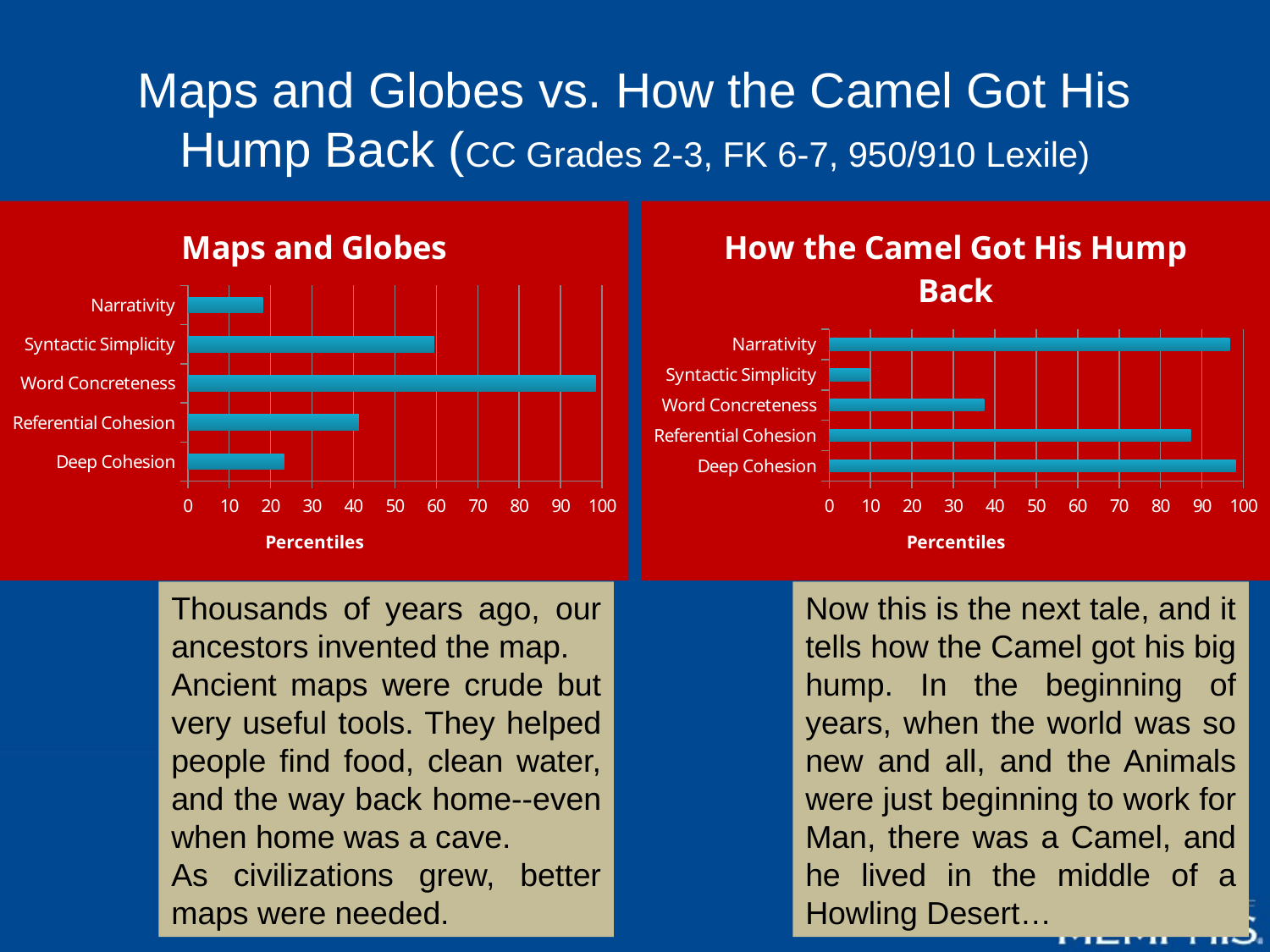
In the "How the Camel Got His Hump Back" chart, which category has the lowest percentile? Syntactic Simplicity In the "Maps and Globes" chart, which category has the highest percentile? Word Concreteness What kind of chart is the "Maps and Globes" chart? bar chart In the "How the Camel Got His Hump Back" chart, is the value for Referential Cohesion greater or less than 80? greater What is the x-axis title of the "Maps and Globes" chart? Percentiles In the "How the Camel Got His Hump Back" chart, is the value for Word Concreteness greater or less than 50? less In the "Maps and Globes" chart, is the value for Word Concreteness greater or less than 90? greater How many categories are shown in the "How the Camel Got His Hump Back" chart? 5 In the "Maps and Globes" chart, which is larger: Referential Cohesion or Deep Cohesion? Referential Cohesion In the "How the Camel Got His Hump Back" chart, which is larger: Narrativity or Syntactic Simplicity? Narrativity How many categories are shown in the "Maps and Globes" chart? 5